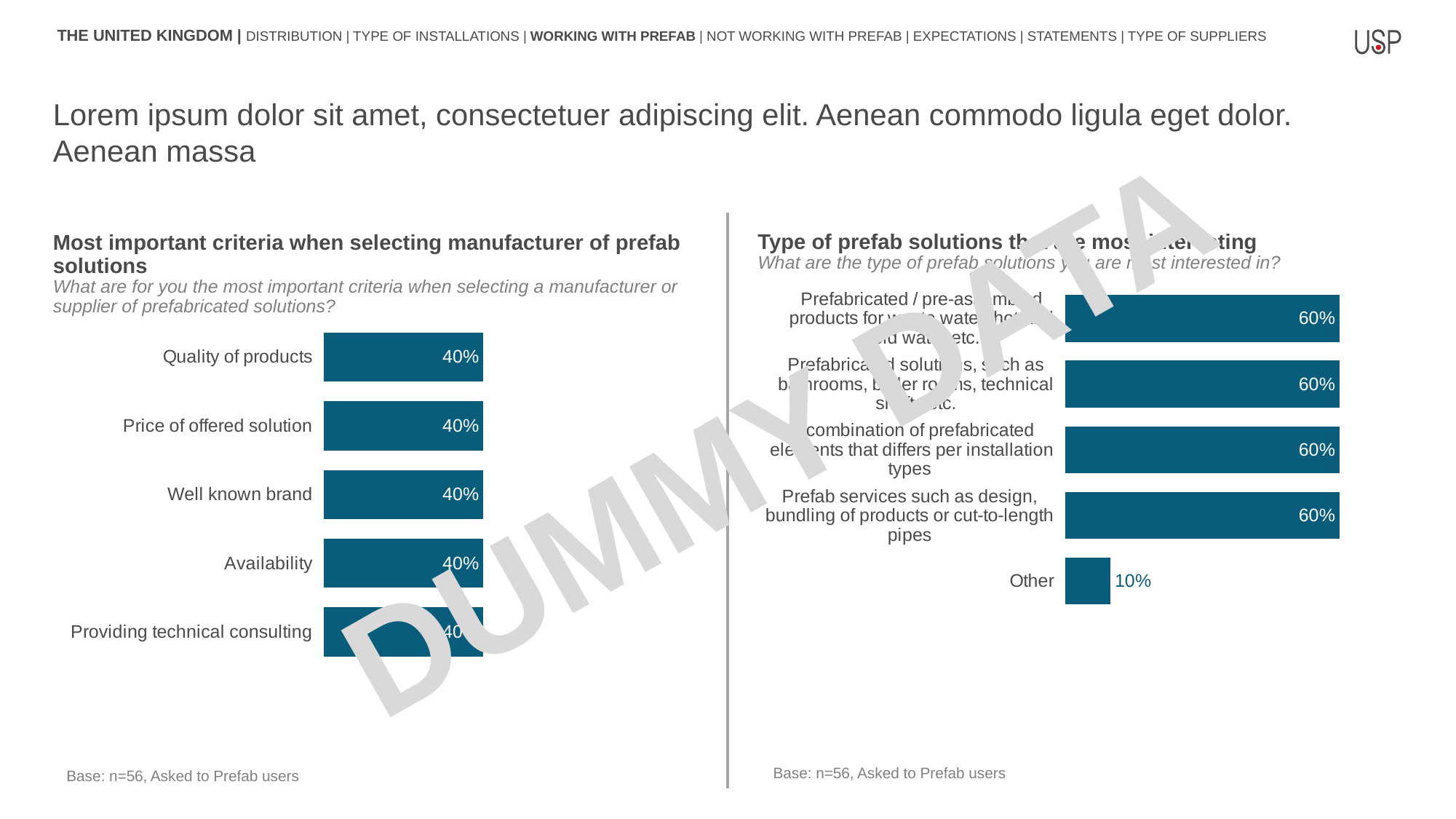
What is the title of the left-hand chart? Most important criteria when selecting manufacturer of prefab solutions On the right-hand chart, what is the value for Prefab services such as design, bundling of products or cut-to-length pipes? 60% On the right-hand chart, which is larger: Prefab services such as design, bundling of products or cut-to-length pipes, or Other? Prefab services such as design, bundling of products or cut-to-length pipes On the left-hand chart, what is the value for Availability? 40% On the right-hand chart, how many categories are plotted? 5 On the right-hand chart, what is the value for Other? 10% On the left-hand chart, what is the value for Price of offered solution? 40% On the left-hand chart, how many categories are plotted? 5 On the right-hand chart, what is the difference between Prefab services such as design, bundling of products or cut-to-length pipes and Other? 50 percentage points On the right-hand chart, which category has the lowest value? Other What kind of chart is the left-hand chart? Bar chart On the left-hand chart, what is the value for Quality of products? 40%